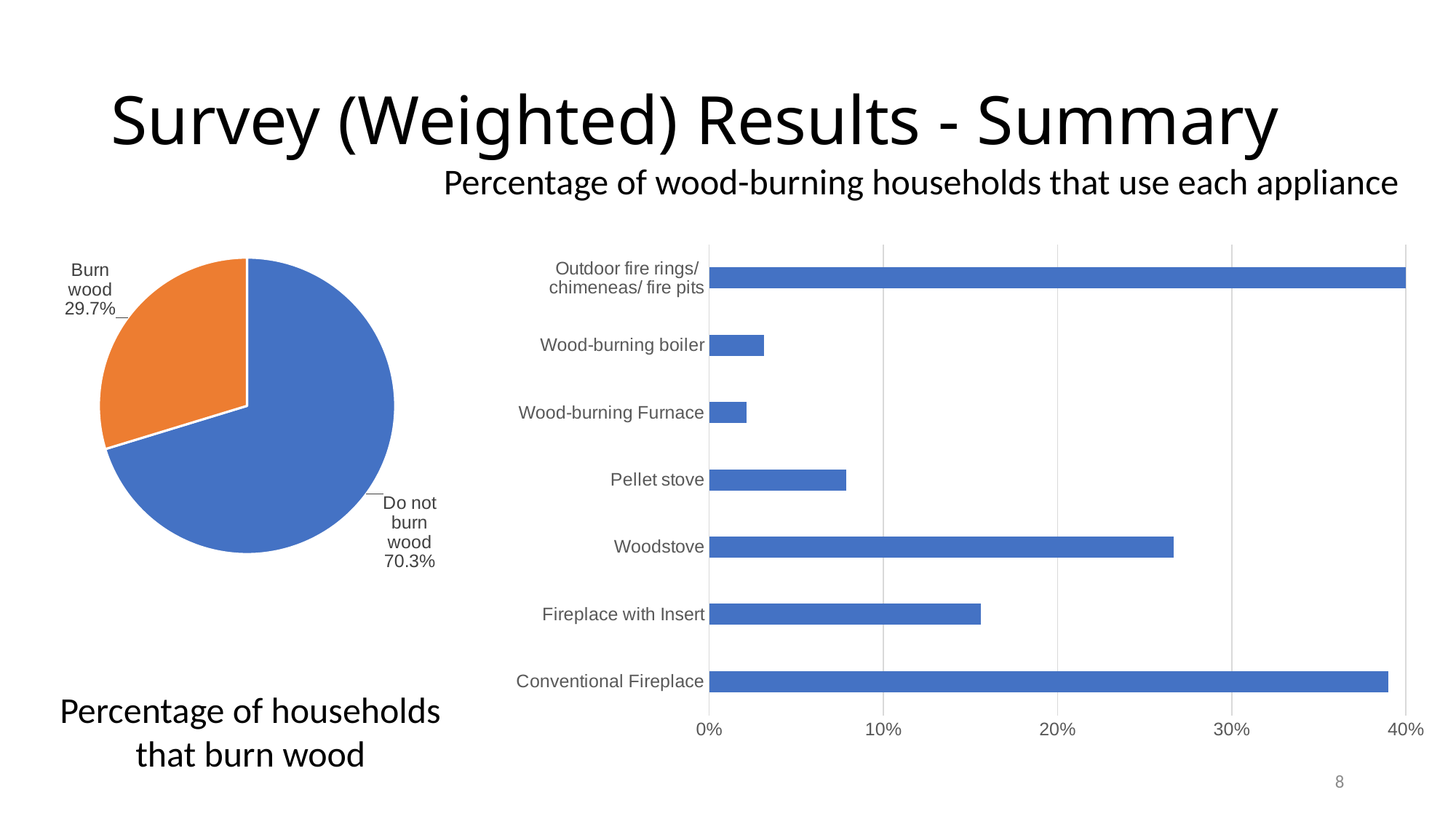
In the chart 'Percentage of wood-burning households that use each appliance', which has a higher value: Pellet stove or Wood-burning Furnace? Pellet stove How many slices does the pie chart 'Percentage of households that burn wood' have? 2 In the chart 'Percentage of wood-burning households that use each appliance', is the value for Fireplace with Insert greater or less than 10%? greater In the pie chart 'Percentage of households that burn wood', what percentage of households do not burn wood? 70.3% In the chart 'Percentage of wood-burning households that use each appliance', which has a higher value: Woodstove or Fireplace with Insert? Woodstove In the pie chart 'Percentage of households that burn wood', what is the difference between the 'Do not burn wood' and 'Burn wood' shares? 40.6% In the pie chart 'Percentage of households that burn wood', what percentage of households burn wood? 29.7% In the pie chart 'Percentage of households that burn wood', which slice is larger: 'Burn wood' or 'Do not burn wood'? Do not burn wood In the chart 'Percentage of wood-burning households that use each appliance', is the value for Pellet stove greater or less than 10%? less What kind of chart is 'Percentage of wood-burning households that use each appliance'? Bar chart In the chart 'Percentage of wood-burning households that use each appliance', is the value for Woodstove greater or less than 20%? greater How many appliance categories are shown in the chart 'Percentage of wood-burning households that use each appliance'? 7